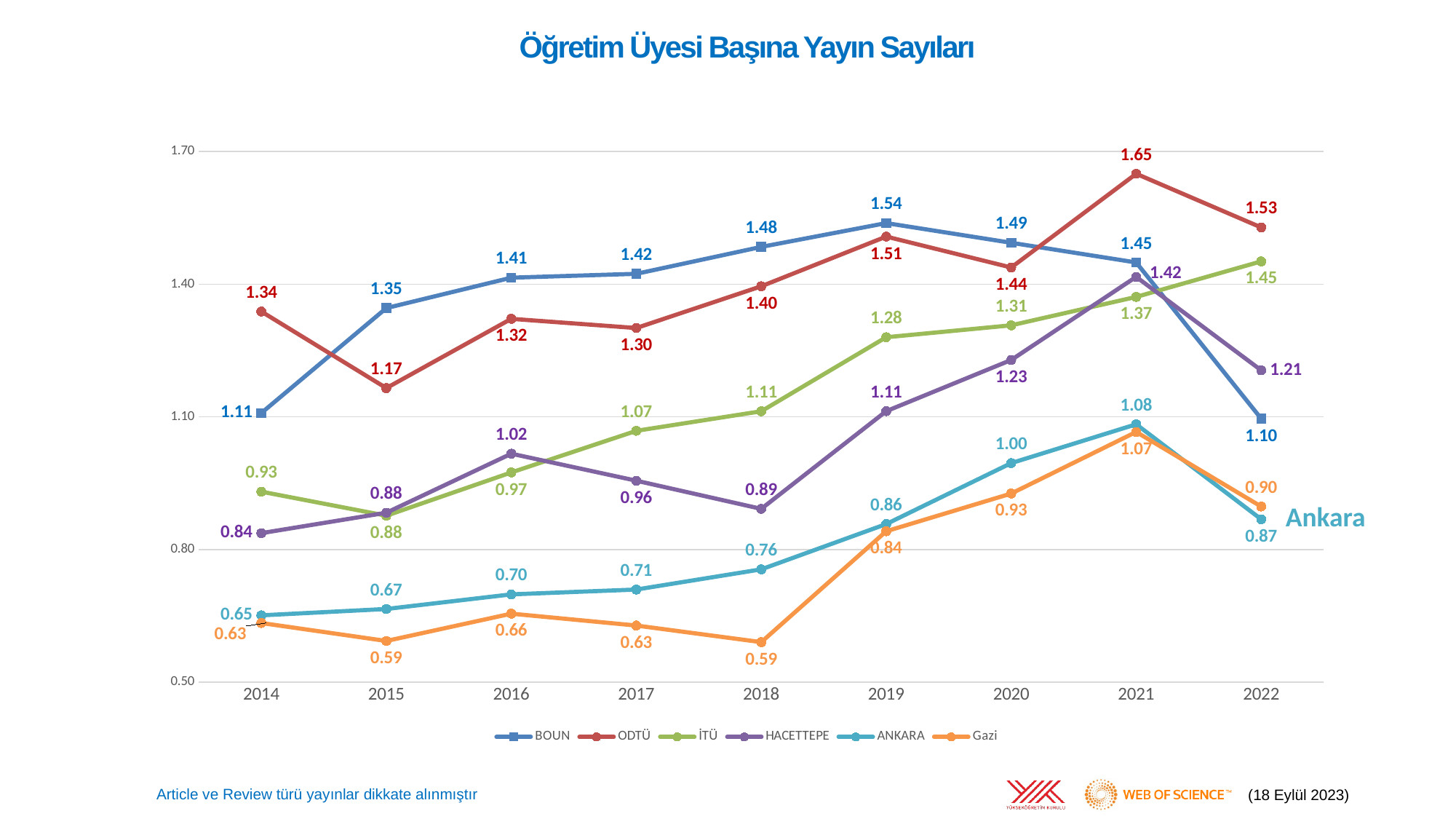
How many years are shown on the x axis? 9 What is the title of the chart? Öğretim Üyesi Başına Yayın Sayıları What is the difference between the ODTÜ and BOUN values in 2022? 0.43 What kind of chart is shown on the slide? Line chart What is the value for ANKARA in 2018? 0.76 What is the value for Gazi in 2015? 0.59 Do the İTÜ values rise or fall from 2015 to 2022? Rise How many series does the legend list? 6 What is the value for ODTÜ in 2021? 1.65 In which year does BOUN reach its highest value? 2019 Which is larger in 2021, the value for HACETTEPE or the value for İTÜ? HACETTEPE Which series has the lowest value in 2014? Gazi